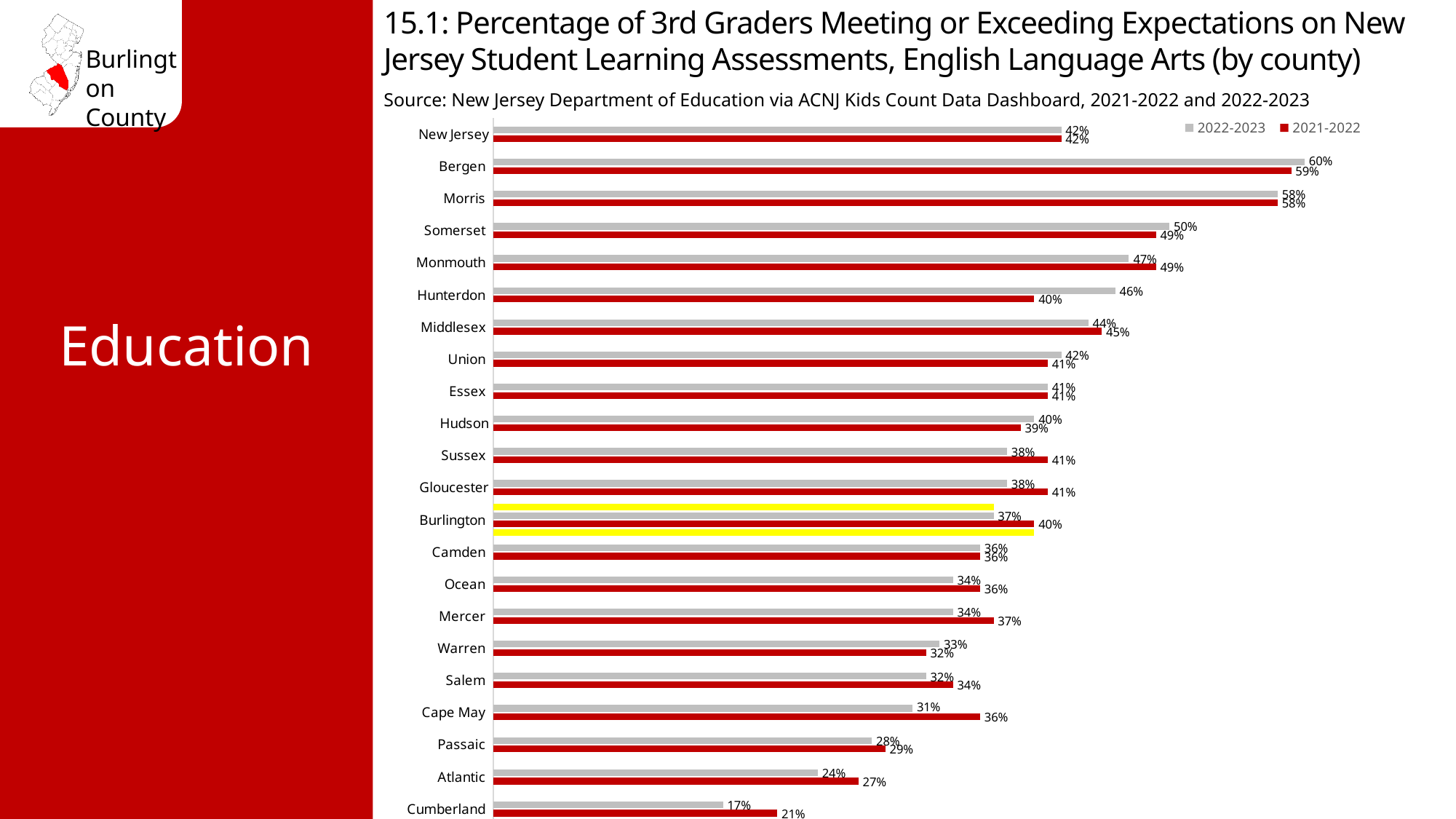
What is the 2022-2023 value for New Jersey overall? 42% What percentage of 3rd graders in Burlington met or exceeded expectations in 2022-2023? 37% By how much did Hunterdon's value change from 2021-2022 to 2022-2023? 6% How many series does the legend list? 2 Which county has the highest 2022-2023 value? Bergen How many categories (counties plus New Jersey) are shown on the chart? 22 What was the 2021-2022 value for Hunterdon? 40% Which is larger for Cape May: the 2022-2023 value or the 2021-2022 value? 2021-2022 What is the difference between Bergen's 2022-2023 value and Cumberland's 2022-2023 value? 43% Which county has the lowest 2021-2022 value? Cumberland Which series is shown in red in the legend? 2021-2022 What kind of chart is shown on the slide? Bar chart